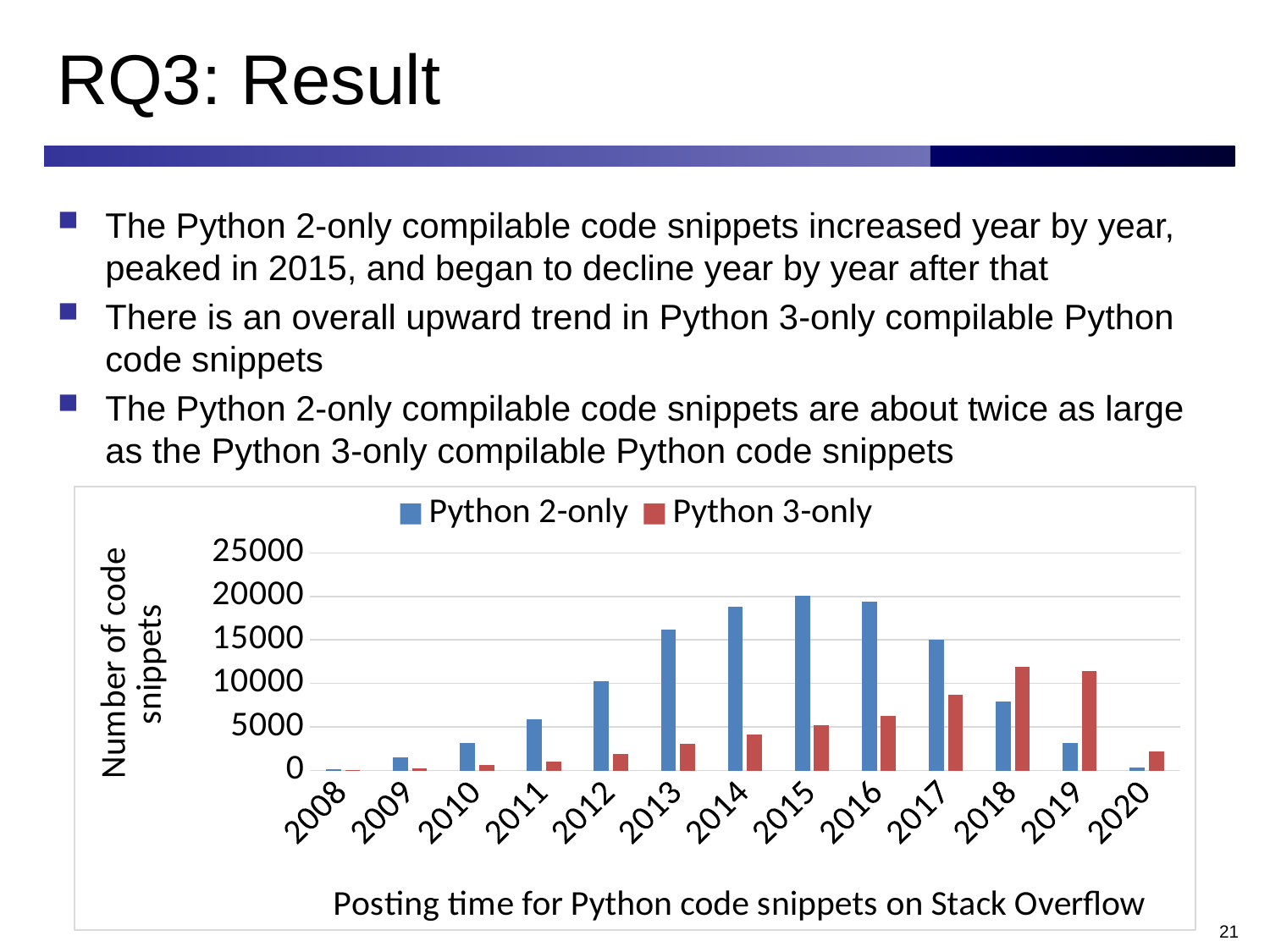
How many years are shown on the x axis of the chart? 13 In 2019, which series has the larger value, Python 2-only or Python 3-only? Python 3-only Is the Python 2-only value for 2013 greater or less than 15000? greater Do the Python 2-only values rise or fall from 2008 to 2015? rise In which year is the Python 2-only value highest? 2015 Is the Python 3-only value for 2018 greater or less than 10000? greater What kind of chart is shown on the slide? bar chart Is the Python 2-only value for 2018 greater or less than 10000? less What is the x-axis title of the chart? Posting time for Python code snippets on Stack Overflow In which year is the Python 2-only value lowest? 2008 How many series does the legend list? 2